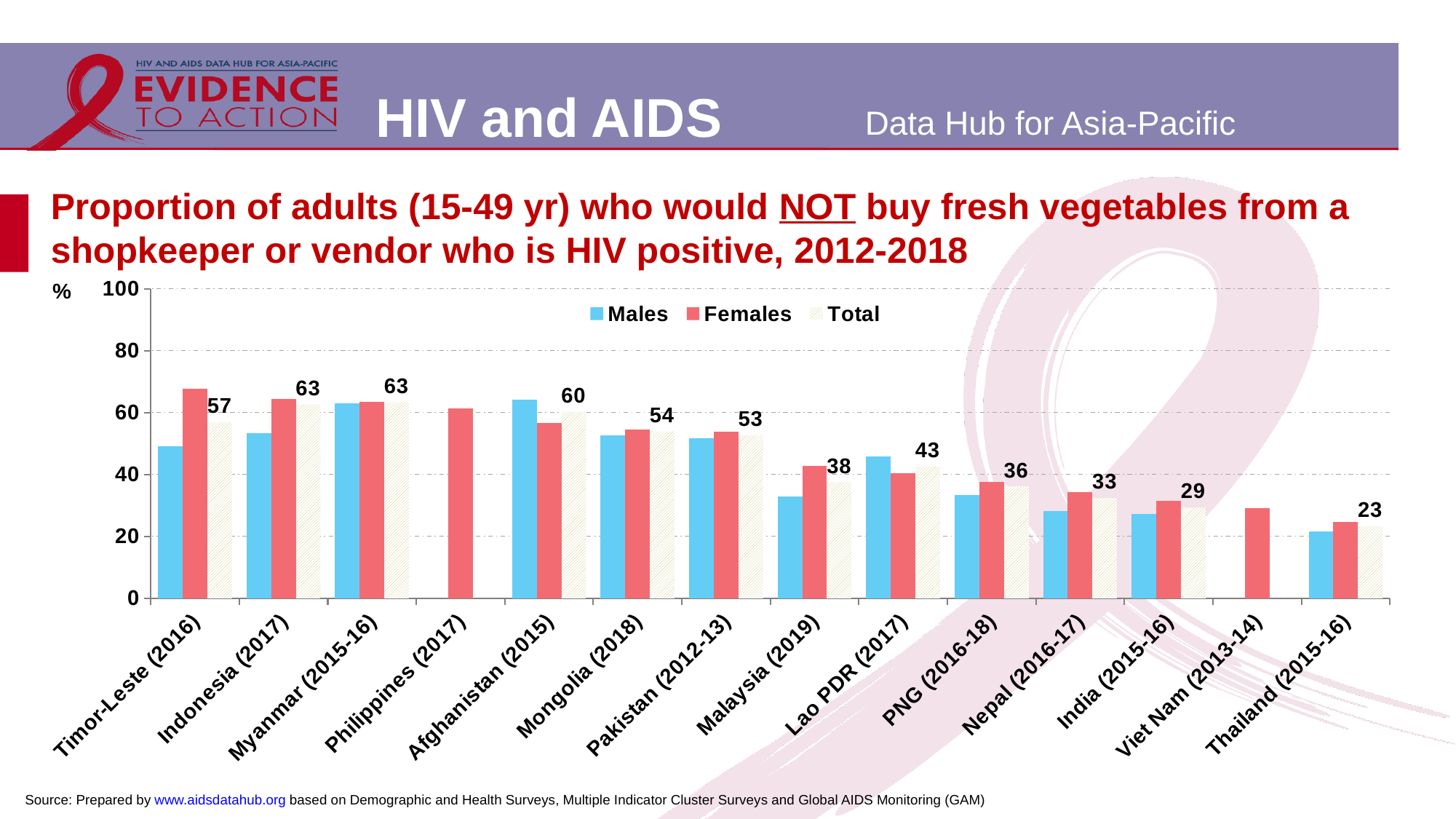
Is the Females value for Viet Nam (2013-14) greater or less than 40? less How many countries are shown on the x axis? 14 Which country has the lowest Total value? Thailand (2015-16) What is the Total value for Thailand (2015-16)? 23 What is the difference between the Total values for Lao PDR (2017) and PNG (2016-18)? 7 What is the Total value for Timor-Leste (2016)? 57 What is the Total value for Afghanistan (2015)? 60 Is the Males value for Timor-Leste (2016) greater or less than 60? less What kind of chart is shown on the slide? bar chart How many series does the legend list? 3 What is the difference between the Total values for Afghanistan (2015) and Mongolia (2018)? 6 Which has a larger Total value, Malaysia (2019) or Lao PDR (2017)? Lao PDR (2017)